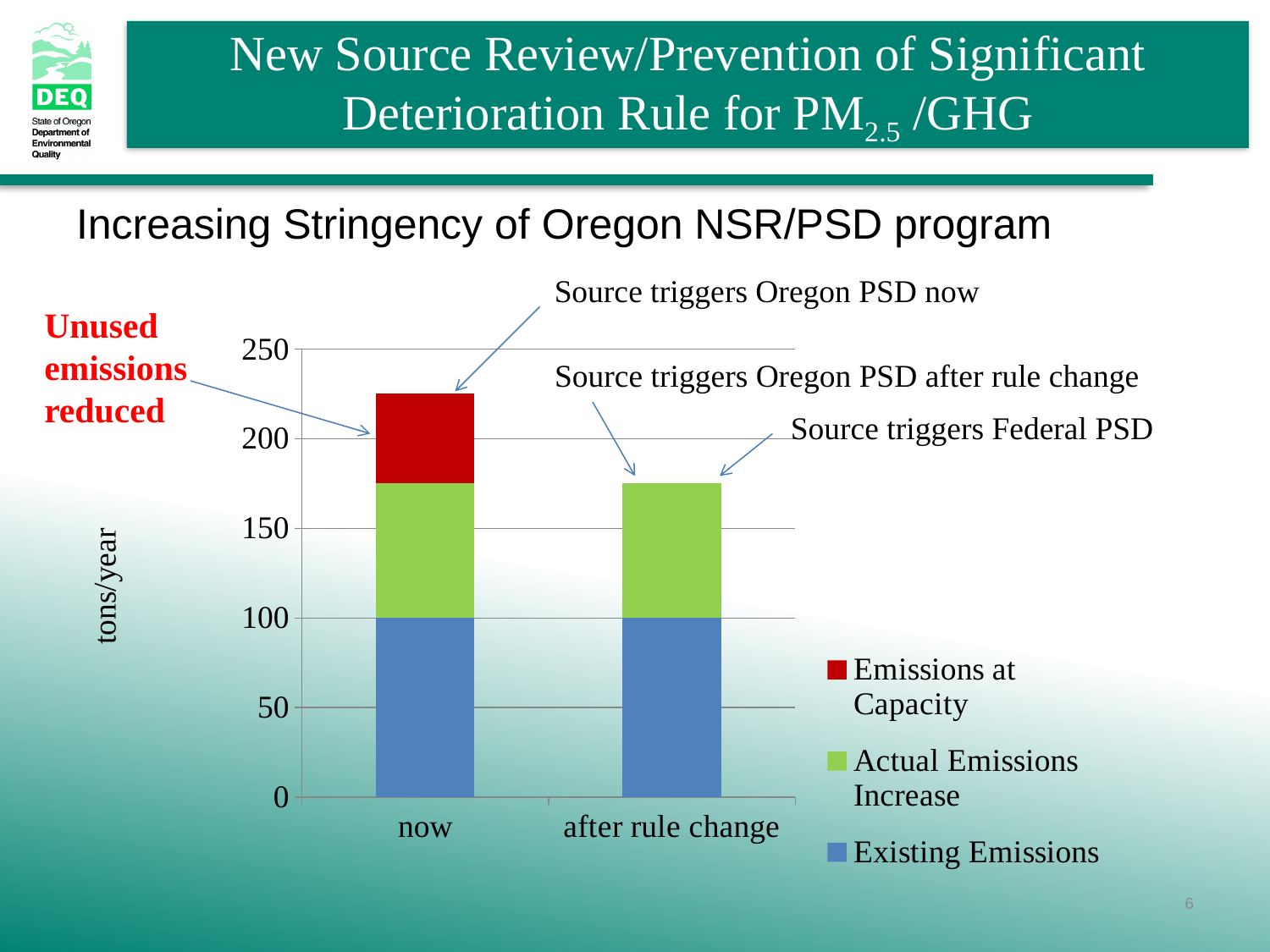
What is the value of Existing Emissions for the "after rule change" bar? 100 Is the total height of the "now" bar greater or less than 200? greater Which category has no Emissions at Capacity segment? after rule change How many series does the chart legend list? 3 What is the value of Existing Emissions for the "now" bar? 100 Do the total bar heights rise or fall from "now" to "after rule change"? fall Is the total height of the "after rule change" bar greater or less than 200? less What is the label on the y axis of the chart? tons/year Is the total height of the "after rule change" bar greater or less than 150? greater What kind of chart is shown on the slide? stacked bar chart Which bar is taller in total, "now" or "after rule change"? now How many categories are shown on the x axis of the chart? 2